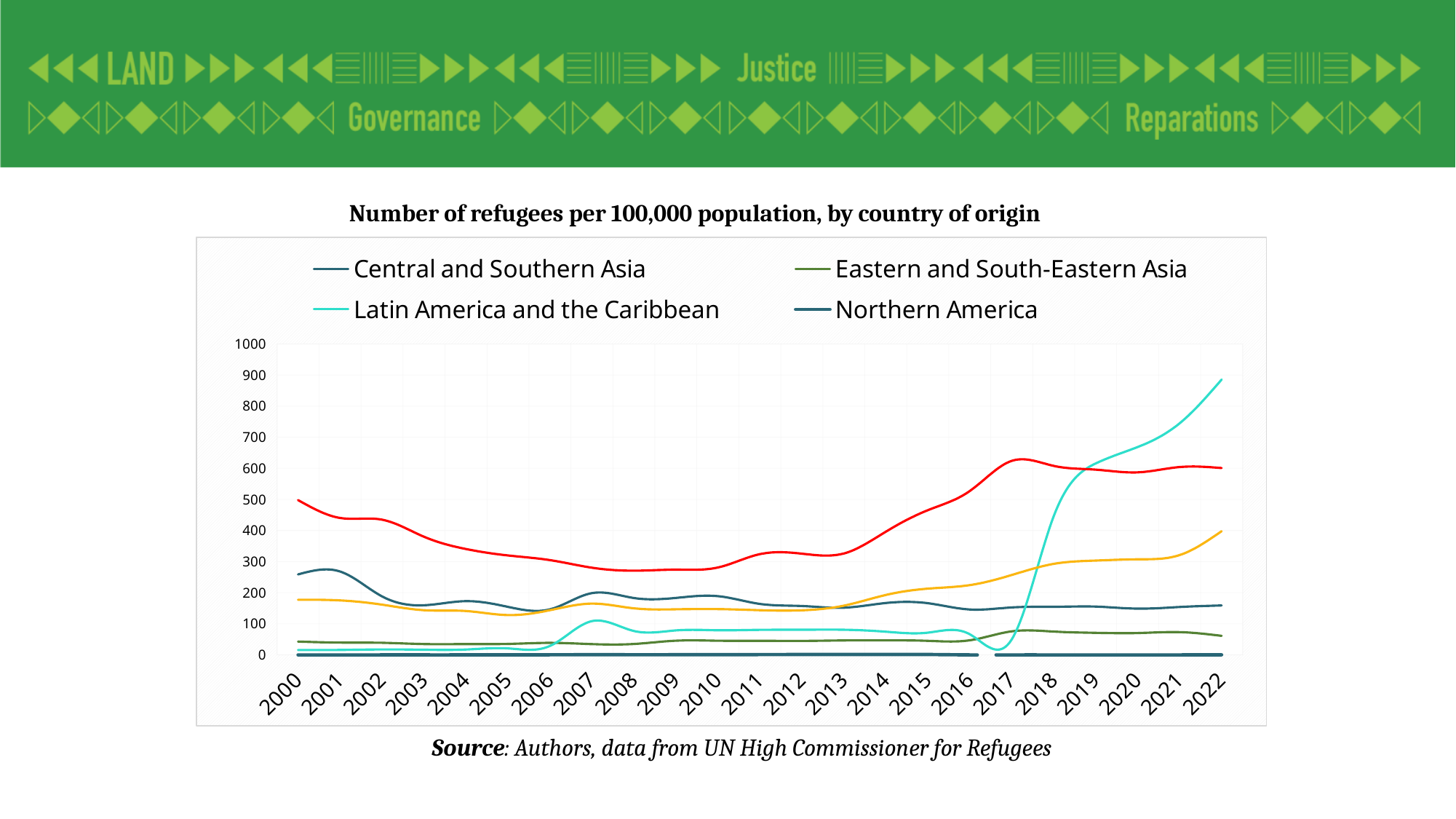
Does the Latin America and the Caribbean line rise or fall between 2017 and 2022? rise Does the Central and Southern Asia line rise or fall between 2000 and 2006? fall In 2022, which is larger: Latin America and the Caribbean or Central and Southern Asia? Latin America and the Caribbean Is the value for Central and Southern Asia in 2000 greater or less than 200? greater What kind of chart is shown on the slide? line chart How many years are shown along the x axis? 23 How many series does the legend list? 4 Which legend series has the lowest values across the whole period? Northern America Is the value for Eastern and South-Eastern Asia in 2022 greater or less than 100? less What is the title of the chart? Number of refugees per 100,000 population, by country of origin Is the value for Latin America and the Caribbean in 2022 greater or less than 800? greater Which series is drawn in the light turquoise line? Latin America and the Caribbean